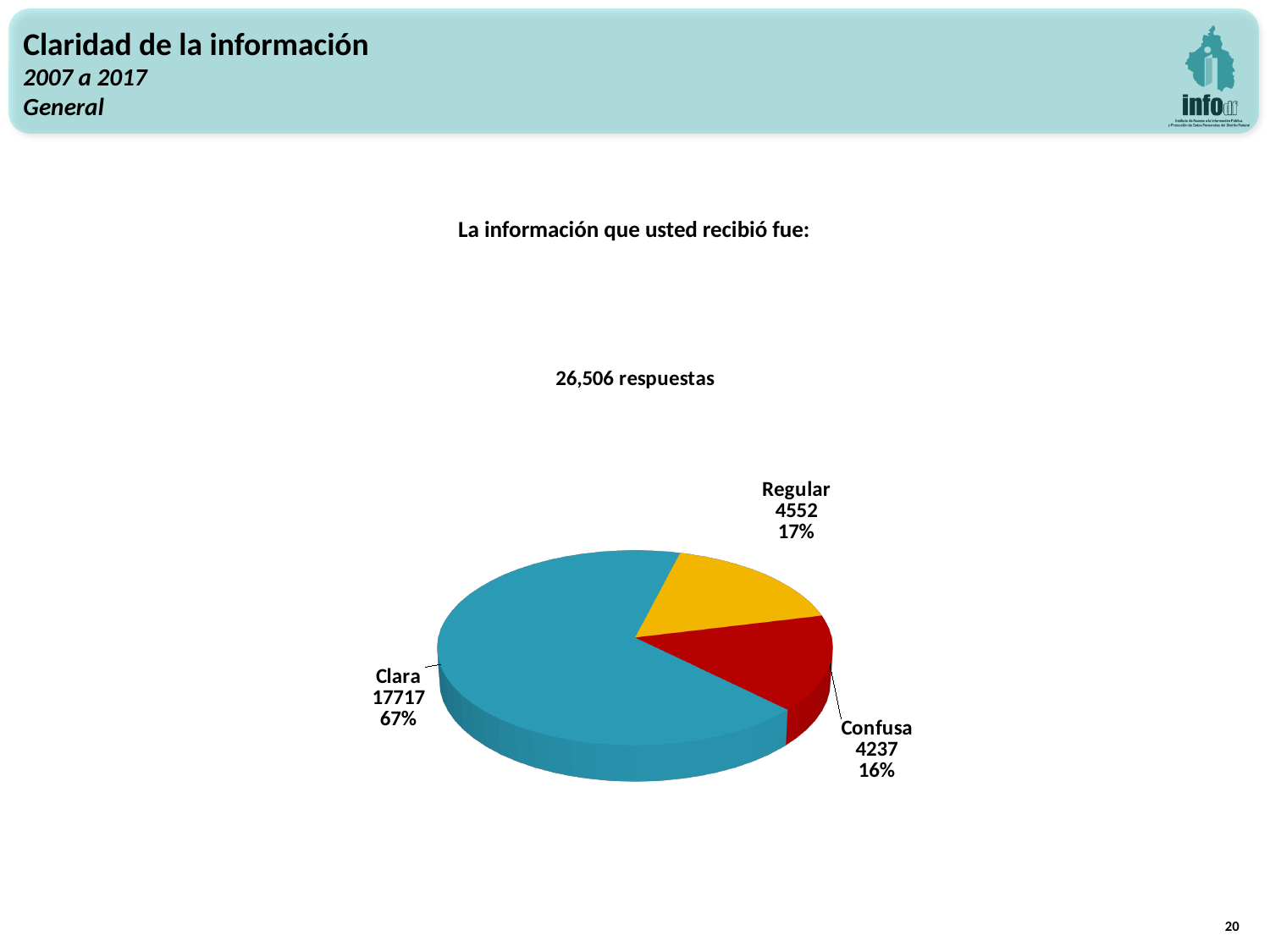
How many slices does the pie chart have? 3 What is the value for Confusa? 4237 What is the difference between the values for Regular and Confusa? 315 What is the value for Regular? 4552 Which category has the largest slice? Clara What share of the pie does Confusa represent? 16% What kind of chart is shown on the slide? pie chart Which category has the smallest slice? Confusa What is the value for Clara? 17717 What is the difference between the values for Clara and Regular? 13165 What share of the pie does Clara represent? 67% How many total responses does the slide report for the chart? 26,506 respuestas